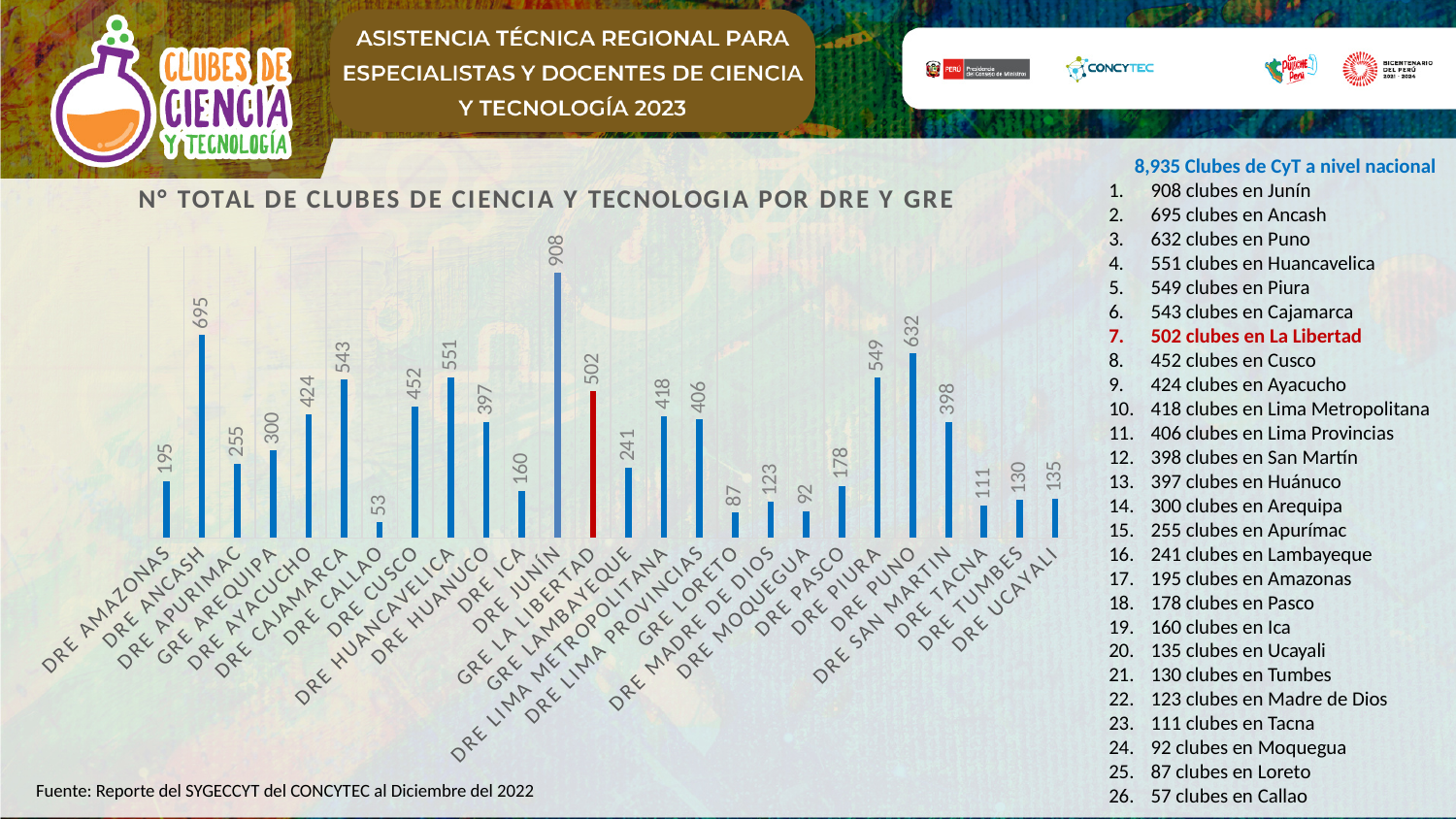
How many DRE/GRE categories are plotted in the chart? 26 What is the value for GRE LORETO? 87 What is the difference between the values for DRE ANCASH and DRE PUNO? 63 What is the value for GRE LA LIBERTAD? 502 Which bar is coloured red instead of blue? GRE LA LIBERTAD What is the value for DRE PUNO? 632 What type of chart is shown on the slide? Bar chart What is the title of the chart? N° TOTAL DE CLUBES DE CIENCIA Y TECNOLOGIA POR DRE Y GRE What is the value for DRE JUNIN? 908 Which is larger, the value for DRE HUANCAVELICA or the value for DRE PIURA? DRE HUANCAVELICA Which category has the lowest value? DRE CALLAO Which category has the highest value? DRE JUNIN